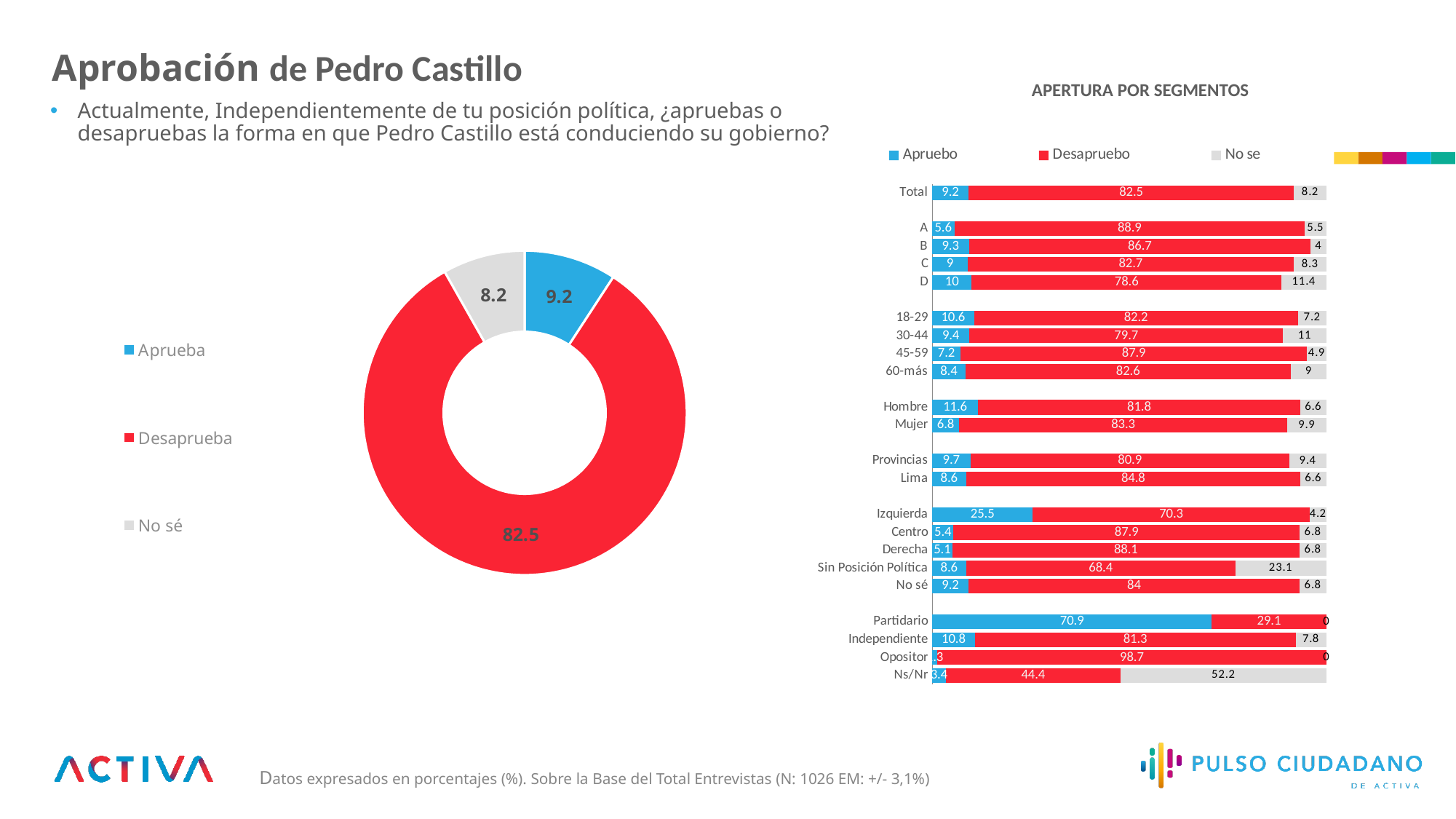
In the APERTURA POR SEGMENTOS chart, which segment has the highest No se value? Ns/Nr What kind of chart is shown on the left of the slide? Donut (pie) chart In the APERTURA POR SEGMENTOS chart, what is the No se value for Sin Posición Política? 23.1 In the APERTURA POR SEGMENTOS chart, which segment has the highest Desapruebo value? Opositor How many series does the legend of the APERTURA POR SEGMENTOS chart list? 3 In the donut chart on the left, which category has the smallest value? No sé In the APERTURA POR SEGMENTOS chart, what is the Apruebo value for Partidario? 70.9 In the APERTURA POR SEGMENTOS chart, what is the Desapruebo value for Izquierda? 70.3 In the APERTURA POR SEGMENTOS chart, is the Apruebo value larger for Hombre or for Mujer? Hombre In the donut chart on the left, what is the difference between Aprueba and No sé? 1 In the APERTURA POR SEGMENTOS chart, what is the difference between the Desapruebo values for Lima and Provincias? 3.9 In the donut chart on the left, what is the value for Desaprueba? 82.5